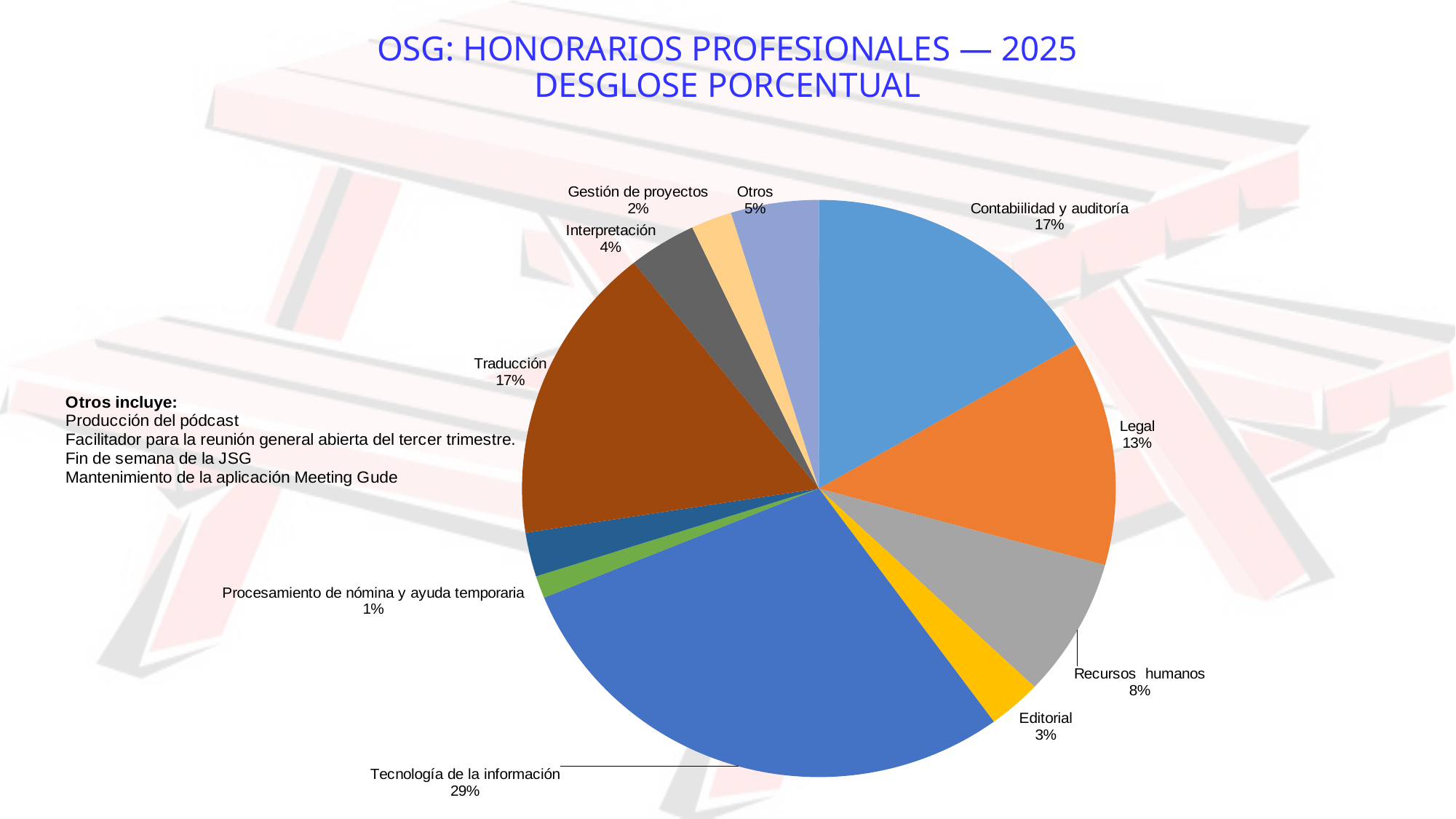
Which labelled category has the smallest share of the pie? Procesamiento de nómina y ayuda temporaria What percentage of the pie does Tecnología de la información represent? 29% What is the title of the chart? OSG: HONORARIOS PROFESIONALES — 2025 DESGLOSE PORCENTUAL What type of chart is shown on the slide? Pie chart What is the difference in percentage points between Tecnología de la información and Traducción? 12 percentage points What is the value shown for Gestión de proyectos? 2% Which category has the largest share of the pie? Tecnología de la información What is the difference in percentage points between Contabilidad y auditoría and Legal? 4 percentage points What is the value shown for Legal? 13% What is the value shown for Recursos humanos? 8% Which is larger, Interpretación or Editorial? Interpretación What share of the pie does Otros represent? 5%